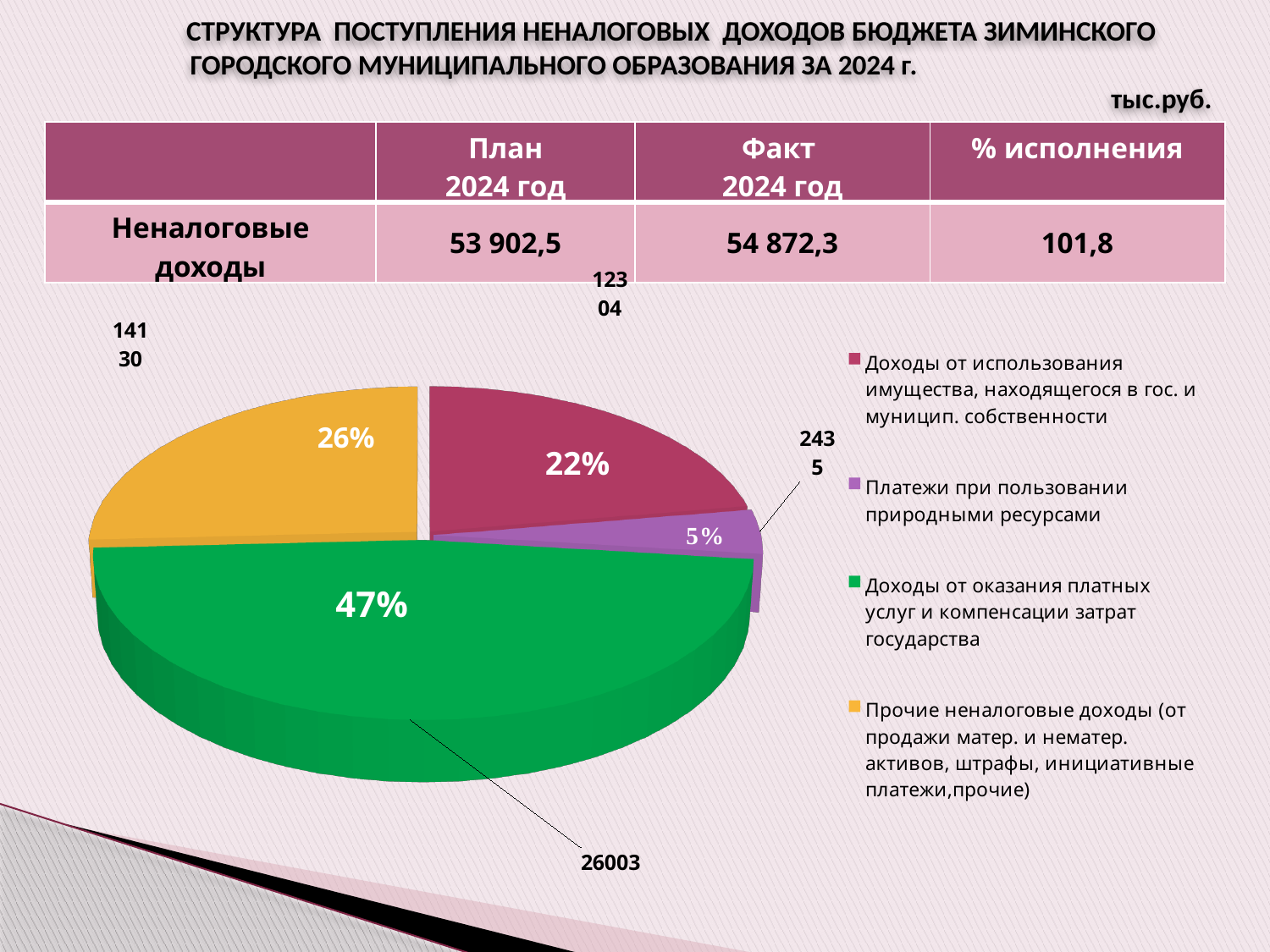
What share of the pie does "Доходы от оказания платных услуг и компенсации затрат государства" have? 47% How many slices does the pie chart have? 4 What kind of chart is shown on the slide? pie chart What share of the pie does "Прочие неналоговые доходы" have? 26% Which category has the largest slice of the pie? Доходы от оказания платных услуг и компенсации затрат государства Which category has the smallest slice of the pie? Платежи при пользовании природными ресурсами What share of the pie does "Платежи при пользовании природными ресурсами" have? 5% How many entries does the legend of the pie chart list? 4 What is the difference in percentage points between the 47% slice and the 26% slice? 21 percentage points Which slice is larger: "Прочие неналоговые доходы" or "Доходы от использования имущества"? Прочие неналоговые доходы What colour is the slice for "Доходы от оказания платных услуг и компенсации затрат государства"? green